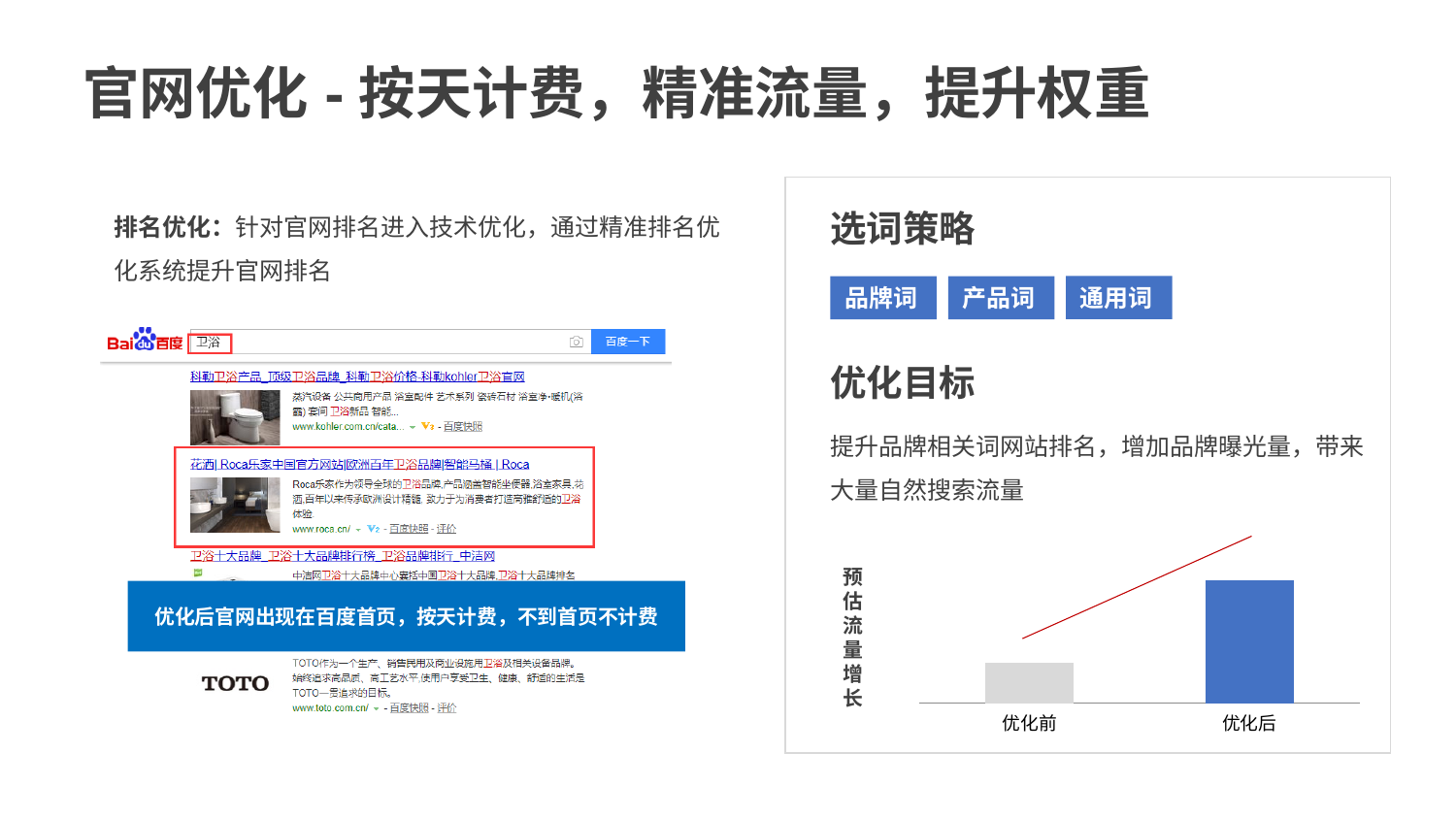
What is the label on the vertical axis of the chart? 预估流量增长 How many categories are shown on the x axis of the chart? 2 Which category has the lowest bar in the chart? 优化前 Which category has the highest bar in the chart? 优化后 Which is larger in the chart, the bar for 优化前 or the bar for 优化后? 优化后 What colour is the bar for 优化后 in the chart? blue Do the values in the chart rise or fall from 优化前 to 优化后? rise What kind of chart is shown on the slide? bar chart